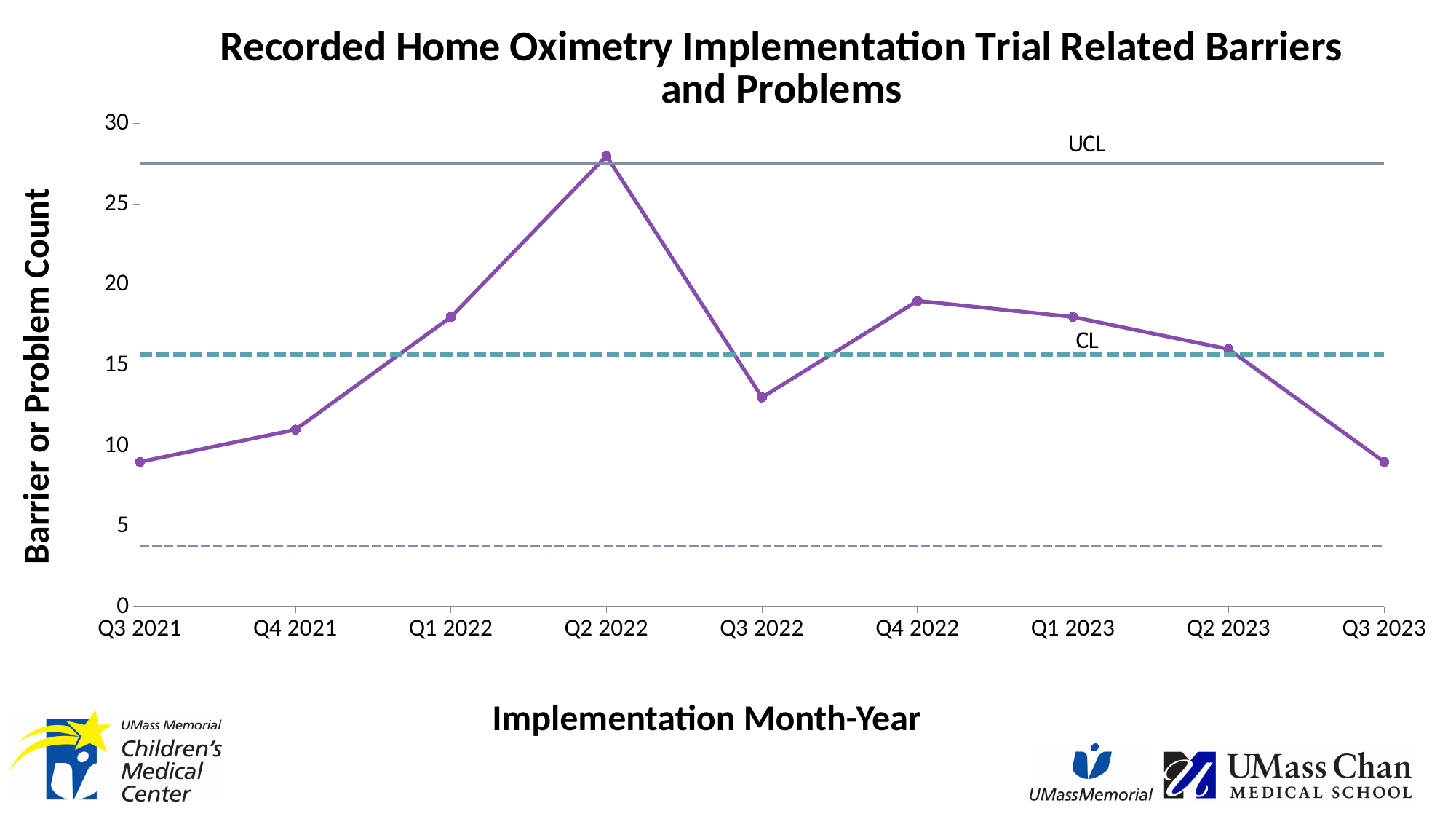
What kind of chart is shown on the slide? line chart Which quarter has the highest barrier or problem count? Q2 2022 Is the value for Q2 2022 greater or less than 25? greater What is the title of the chart? Recorded Home Oximetry Implementation Trial Related Barriers and Problems What is the label of the y axis? Barrier or Problem Count Is the value for Q3 2023 greater or less than 10? less How many quarters are plotted along the x axis? 9 Is the value for Q3 2022 greater or less than 15? less Which has a higher barrier or problem count, Q4 2021 or Q1 2022? Q1 2022 Do the values rise or fall from Q4 2022 to Q3 2023? fall Which has a higher barrier or problem count, Q2 2022 or Q3 2022? Q2 2022